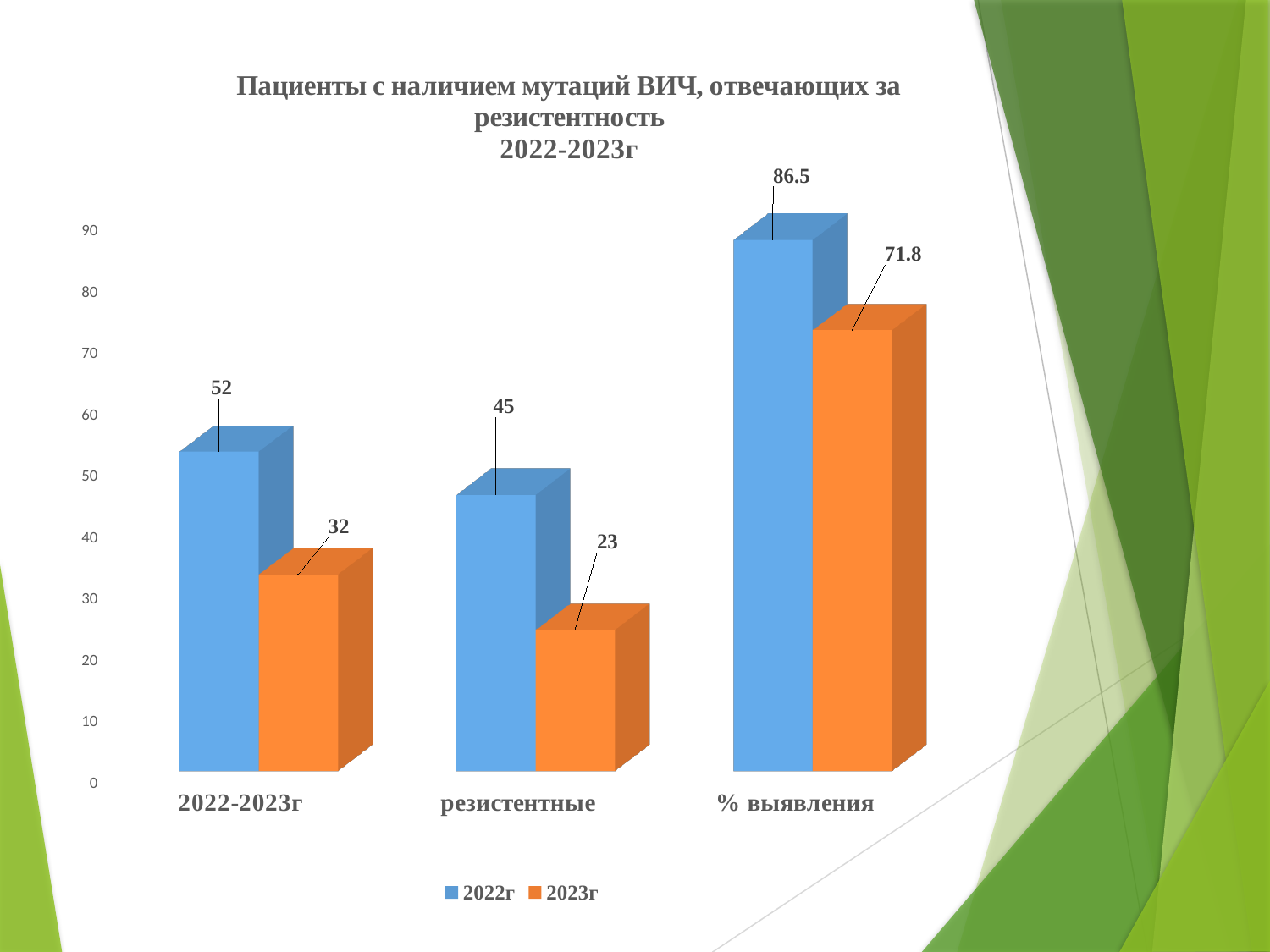
What is the value for 2022г in the "2022-2023г" category? 52 Which category has the lowest value for the 2023г series? резистентные How many series does the legend list? 2 What is the difference between the 2022г and 2023г values in the "резистентные" category? 22 Which is larger in the "2022-2023г" category: the 2022г value or the 2023г value? 2022г What is the difference between the 2022г and 2023г values in the "% выявления" category? 14.7 Which category has the highest value for the 2022г series? % выявления What is the value for 2023г in the "резистентные" category? 23 What is the value for 2022г in the "% выявления" category? 86.5 What kind of chart is shown on the slide? Bar chart What is the value for 2023г in the "% выявления" category? 71.8 How many categories are shown on the x axis? 3